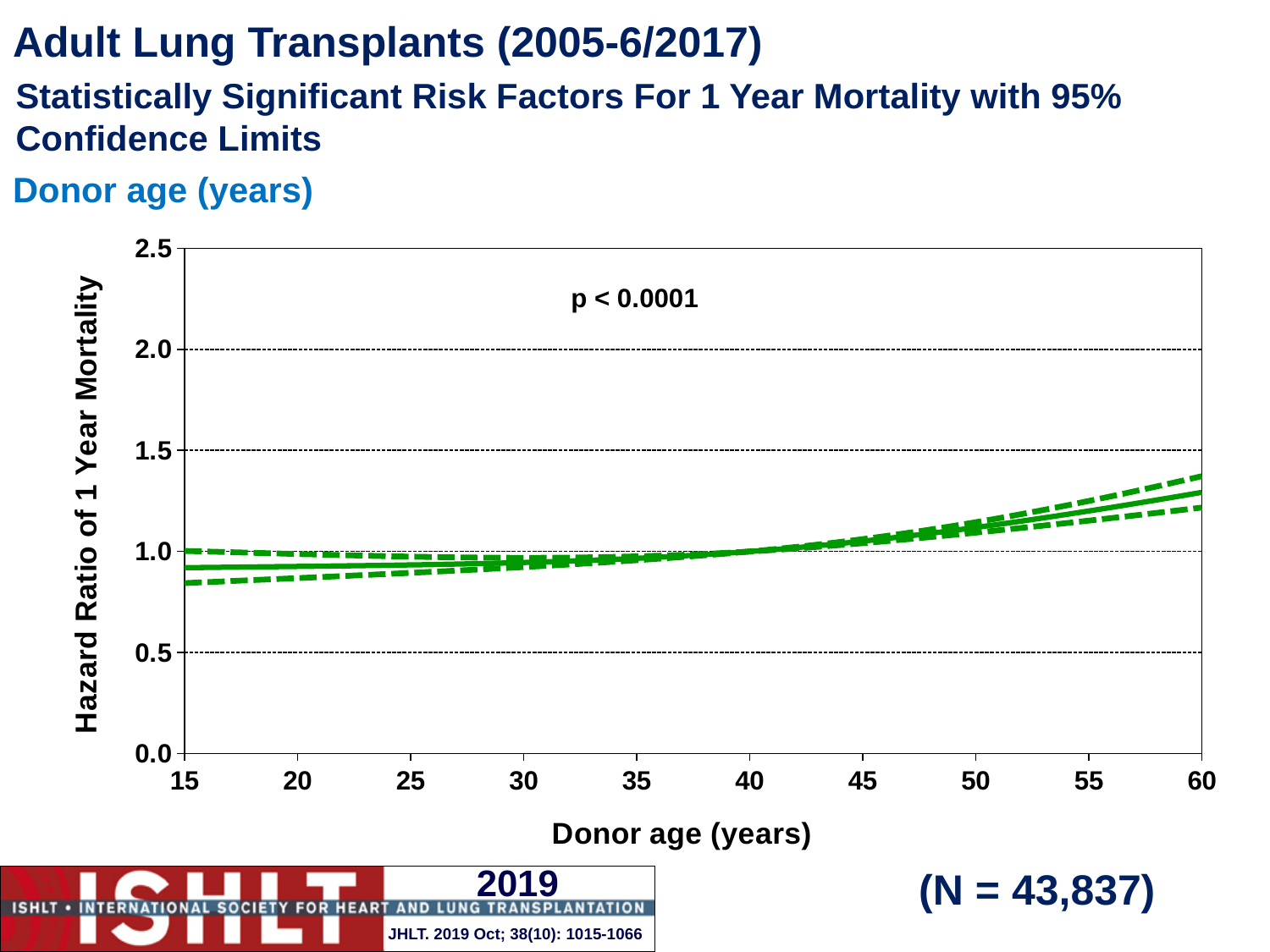
Is the lower 95% confidence limit at a donor age of 15 years greater or less than 0.5? greater Does the hazard ratio of 1 year mortality rise or fall as donor age increases from 15 to 60 years? rise Is the hazard ratio (solid line) at a donor age of 60 years greater or less than 1.0? greater Is the hazard ratio (solid line) at a donor age of 15 years greater or less than 1.0? less What is the label of the x axis? Donor age (years) What p-value is printed on the chart? p < 0.0001 What kind of chart is shown on the slide? line chart